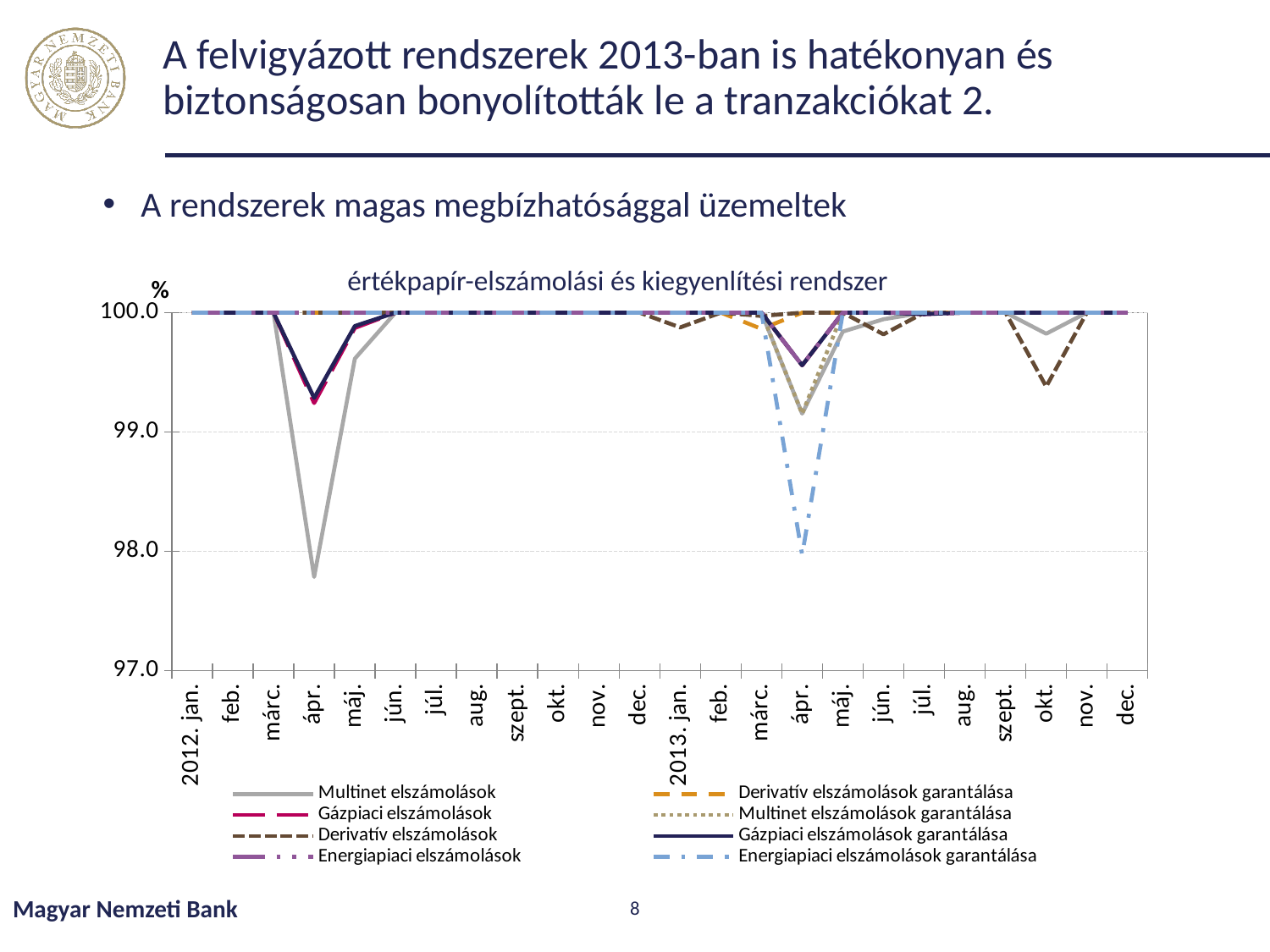
How many series does the chart legend list? 8 What is the title of the chart? értékpapír-elszámolási és kiegyenlítési rendszer Is the value of Gázpiaci elszámolások in 2012 ápr. greater or less than 99.0? greater In 2013 ápr., which is larger: Multinet elszámolások garantálása or Energiapiaci elszámolások garantálása? Multinet elszámolások garantálása Is the value of Multinet elszámolások in 2012 ápr. greater or less than 98.0? less What kind of chart is shown on the slide? line chart Is the value of Derivatív elszámolások in 2013 okt. greater or less than 99.0? greater In which month does the Multinet elszámolások series reach its lowest value? 2012 ápr. In 2012 ápr., which is larger: Multinet elszámolások or Gázpiaci elszámolások? Gázpiaci elszámolások How many monthly points are shown along the x axis of the chart? 24 What unit is shown at the top of the y axis of the chart? %